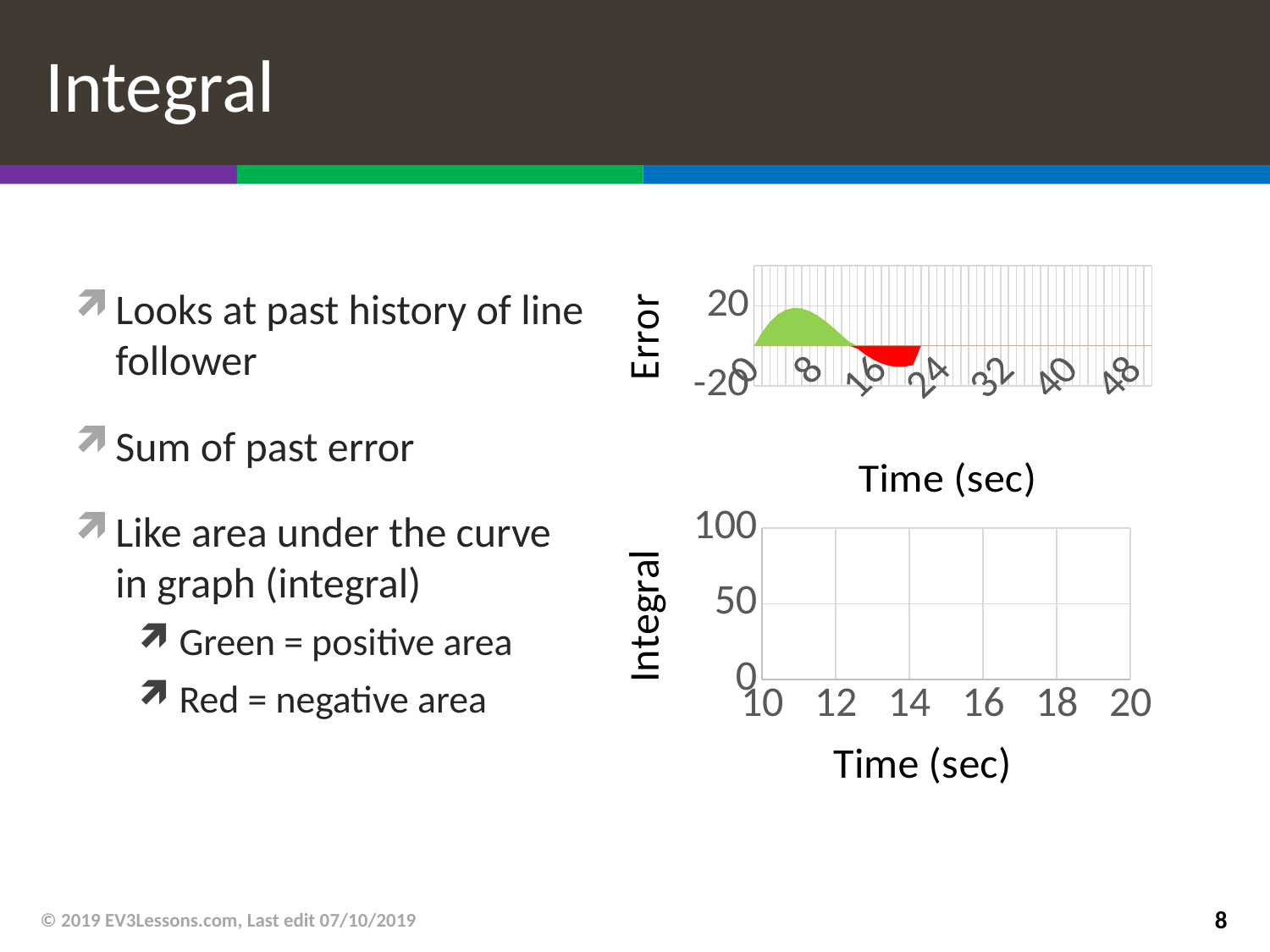
How many tick labels are shown on the x axis of the top chart (Error vs Time)? 7 In the top chart (Error vs Time), does the error rise or fall between time 8 and time 16? fall In the top chart (Error vs Time), is the lowest error value (in the red region) greater or less than -20? greater In the top chart (Error vs Time), is the error at time 8 greater or less than 0? greater What is the y-axis label of the top chart? Error What is the y-axis label of the bottom chart? Integral What kind of chart is the top chart (Error vs Time)? area chart How many tick labels are shown on the x axis of the bottom chart (Integral vs Time)? 6 In the top chart (Error vs Time), is the error at time 20 greater or less than 0? less In the top chart (Error vs Time), which shaded region is larger, the green one or the red one? green